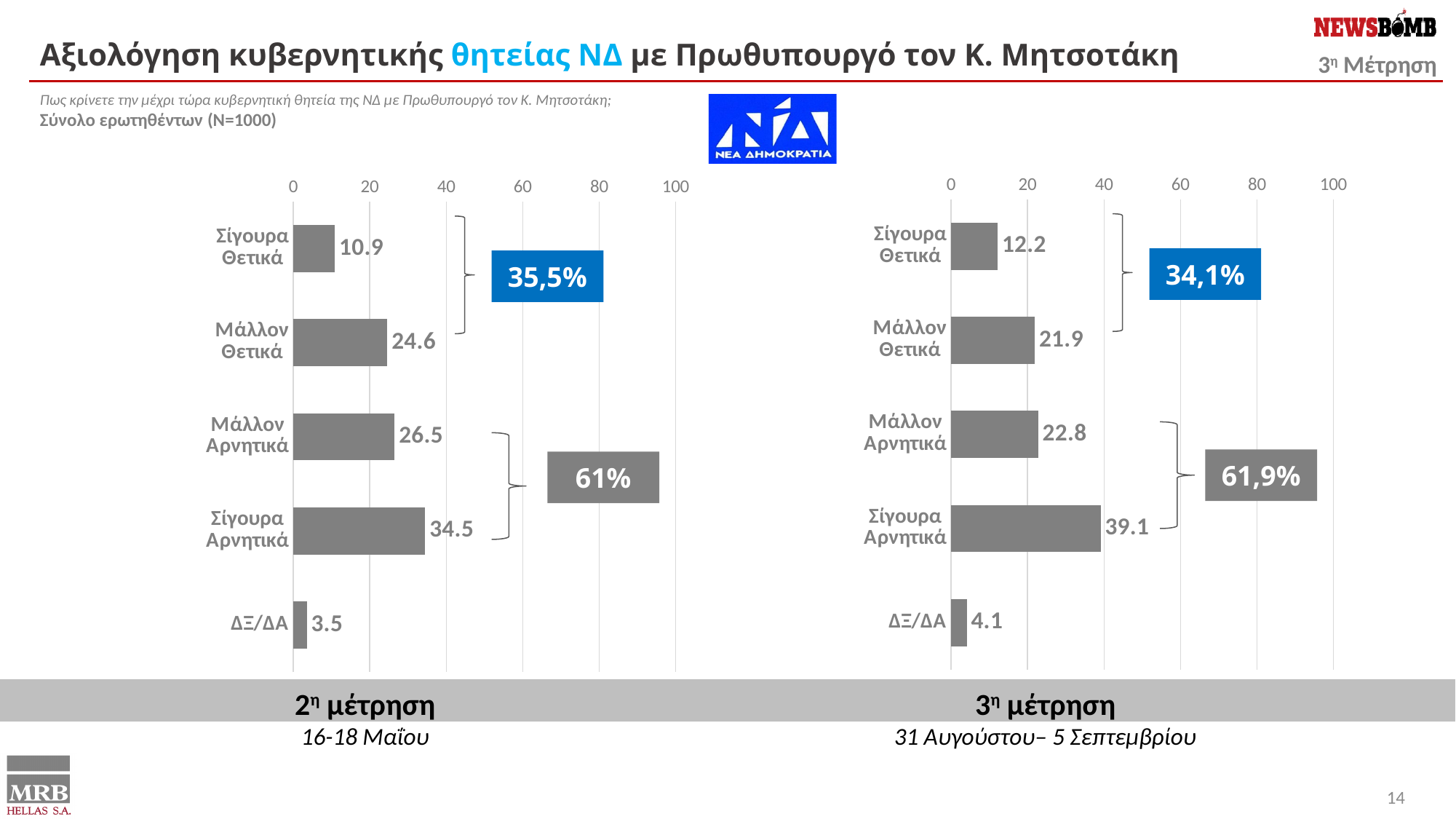
In the right chart (3η μέτρηση), which category has the lowest value? ΔΞ/ΔΑ In the left chart (2η μέτρηση), what is the value for Σίγουρα Θετικά? 10.9 In the right chart (3η μέτρηση), what is the difference between Μάλλον Αρνητικά and Μάλλον Θετικά? 0.9 Which is larger: Μάλλον Θετικά in the left chart (2η μέτρηση) or Μάλλον Θετικά in the right chart (3η μέτρηση)? Left chart (2η μέτρηση) In the left chart (2η μέτρηση), what is the difference between Σίγουρα Αρνητικά and Σίγουρα Θετικά? 23.6 How many categories are shown in the left chart (2η μέτρηση)? 5 In the right chart (3η μέτρηση), is the value for Σίγουρα Αρνητικά greater or less than 20? greater What combined percentage is shown in the blue box for the positive responses in the right chart (3η μέτρηση)? 34,1% In the right chart (3η μέτρηση), what is the value for ΔΞ/ΔΑ? 4.1 In the right chart (3η μέτρηση), what is the value for Σίγουρα Αρνητικά? 39.1 In the left chart (2η μέτρηση), which category has the highest value? Σίγουρα Αρνητικά What type of chart is used on this slide? Bar chart